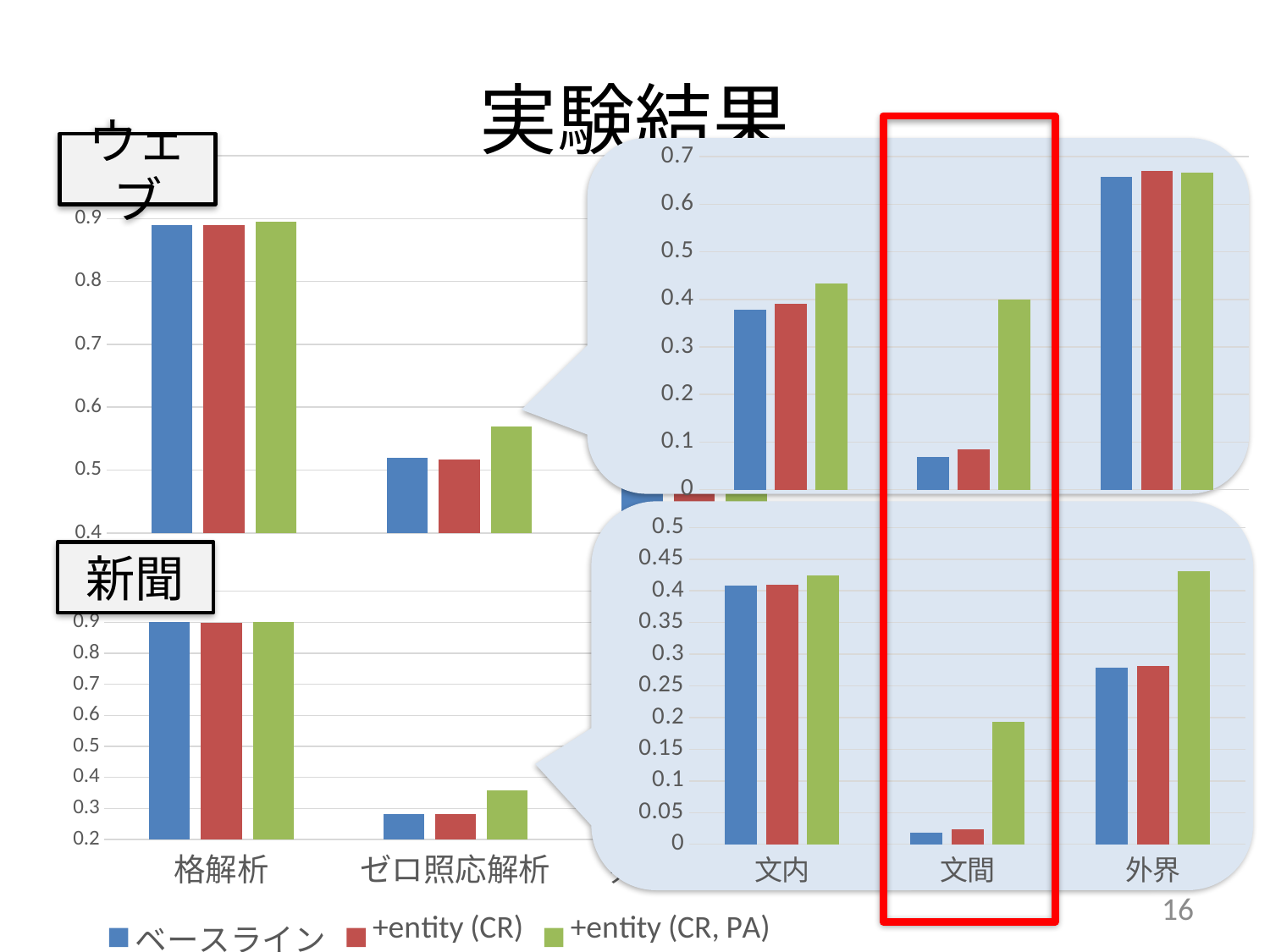
What are the three series named in the legend? ベースライン, +entity (CR), +entity (CR, PA) In the upper callout chart (axis 0 to 0.7), for 文間, which is larger: ベースライン or +entity (CR, PA)? +entity (CR, PA) In the ウェブ chart (top left), for ゼロ照応解析, which is larger: ベースライン or +entity (CR, PA)? +entity (CR, PA) In the ウェブ chart (top left), is the +entity (CR, PA) value for ゼロ照応解析 greater or less than 0.6? less How many series does the legend list? 3 In the lower callout chart (axis 0 to 0.5), is the +entity (CR, PA) value for 外界 greater or less than 0.4? greater In the lower callout chart (axis 0 to 0.5), which category has the lowest ベースライン value? 文間 What kind of chart is used on this slide? bar chart In the ウェブ chart (top left), is the ベースライン value for 格解析 greater or less than 0.8? greater In the upper callout chart (axis 0 to 0.7), which category has the highest +entity (CR, PA) value? 外界